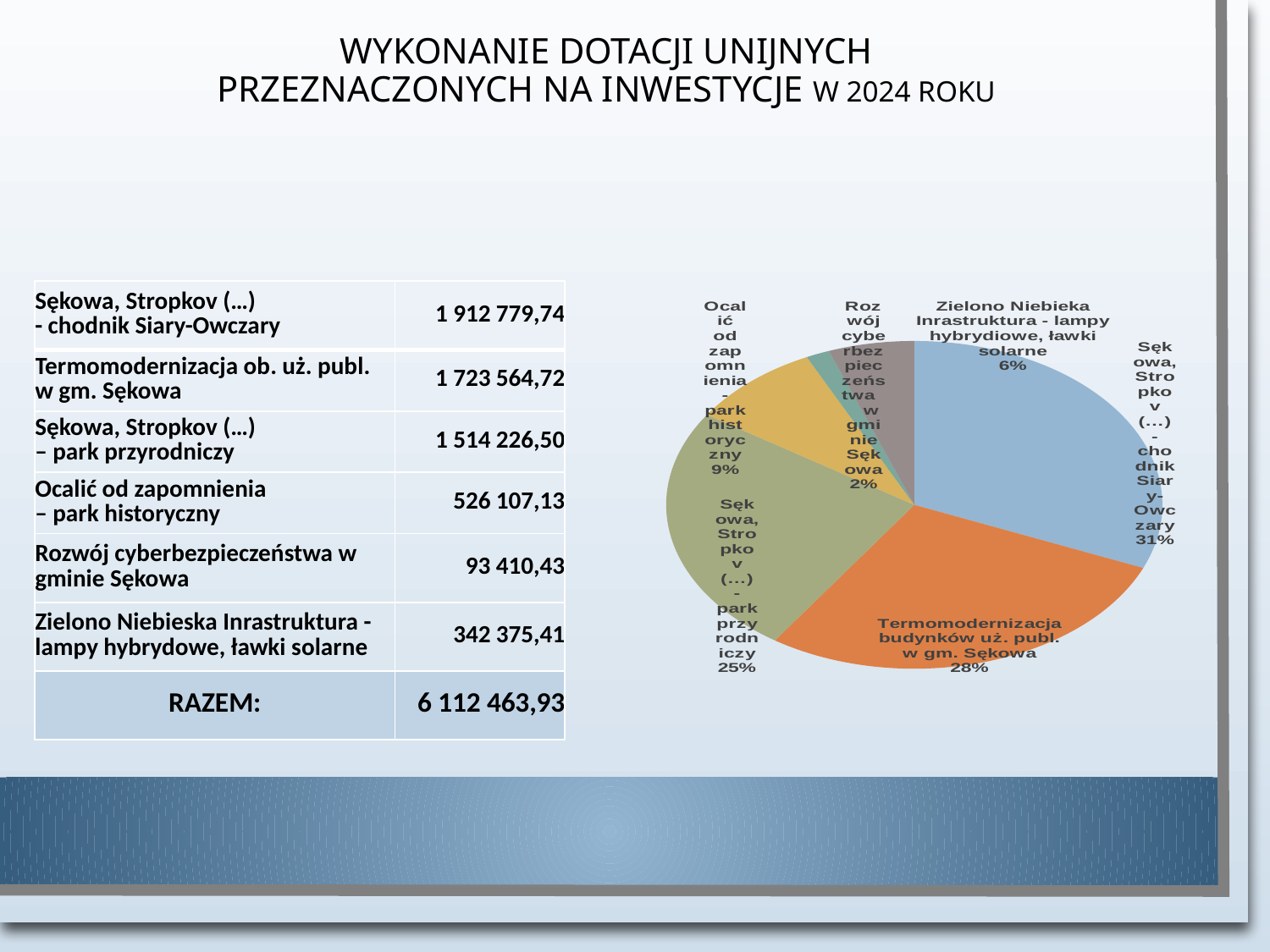
Which slice of the pie chart is the smallest? Rozwój cyberbezpieczeństwa w gminie Sękowa What share of the pie does the slice for 'Rozwój cyberbezpieczeństwa w gminie Sękowa' represent? 2% Which slice is larger: 'Ocalić od zapomnienia - park historyczny' or 'Zielono Niebieska Infrastruktura - lampy hybrydowe, ławki solarne'? Ocalić od zapomnienia - park historyczny What share of the pie does the slice for 'Sękowa, Stropkov (...) - park przyrodniczy' represent? 25% Which slice of the pie chart is the largest? Sękowa, Stropkov (...) - chodnik Siary-Owczary How many slices does the pie chart have? 6 What share of the pie does the slice for 'Zielono Niebieska Infrastruktura - lampy hybrydowe, ławki solarne' represent? 6% What kind of chart is shown on the slide? pie chart What is the difference in percentage points between the 'chodnik Siary-Owczary' slice and the 'park przyrodniczy' slice? 6